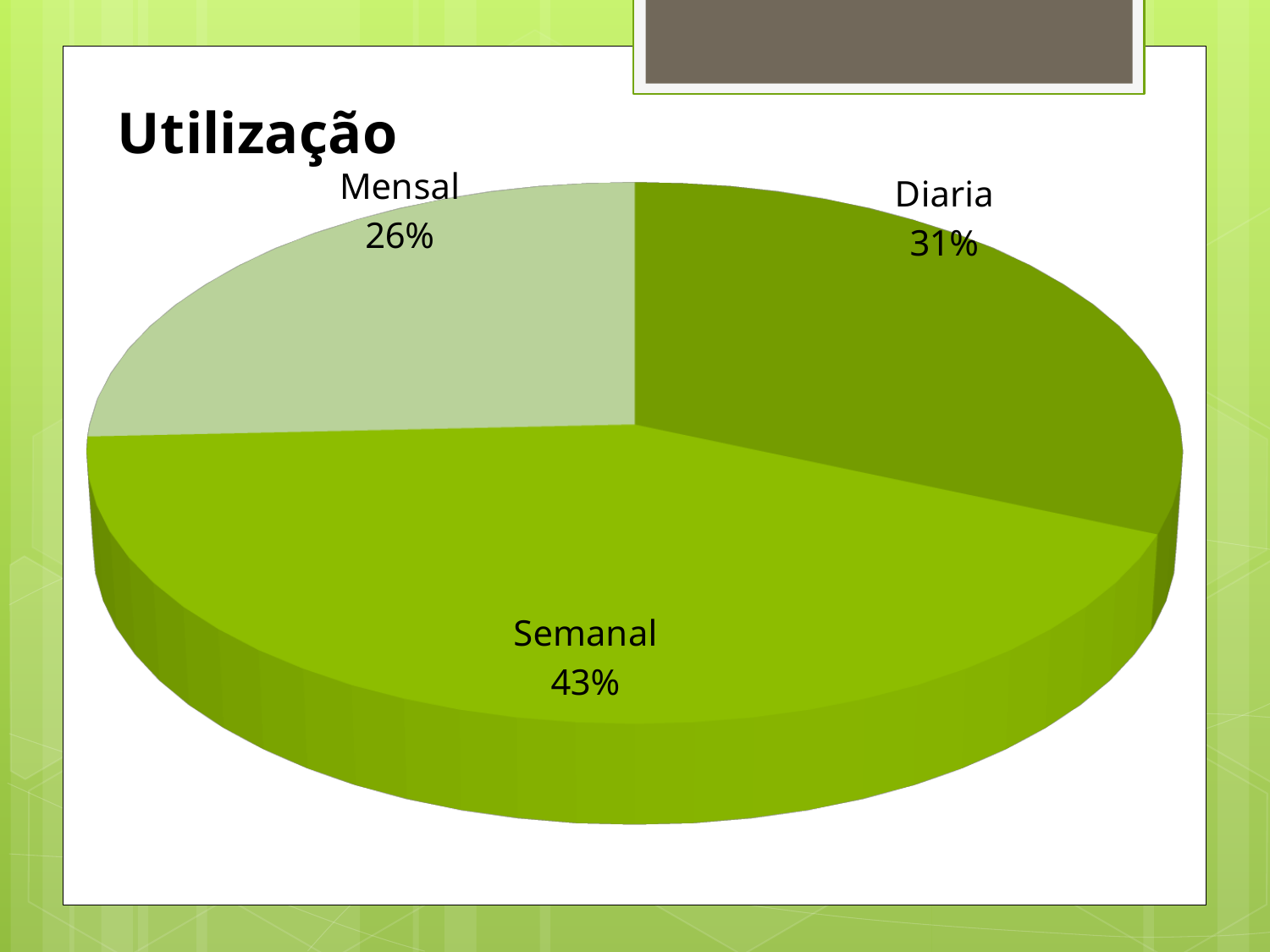
What share of the pie does Semanal represent? 43% Which slice is shown in the lightest green colour? Mensal Which category has the smallest slice? Mensal Which is larger, the Diaria slice or the Mensal slice? Diaria Which category has the largest slice? Semanal How many slices does the pie chart have? 3 What is the title of the chart? Utilização What share of the pie does Diaria represent? 31% What is the difference between the Diaria and Mensal shares? 5% What is the difference between the Semanal and Diaria shares? 12% What share of the pie does Mensal represent? 26% What kind of chart is shown on the slide? pie chart